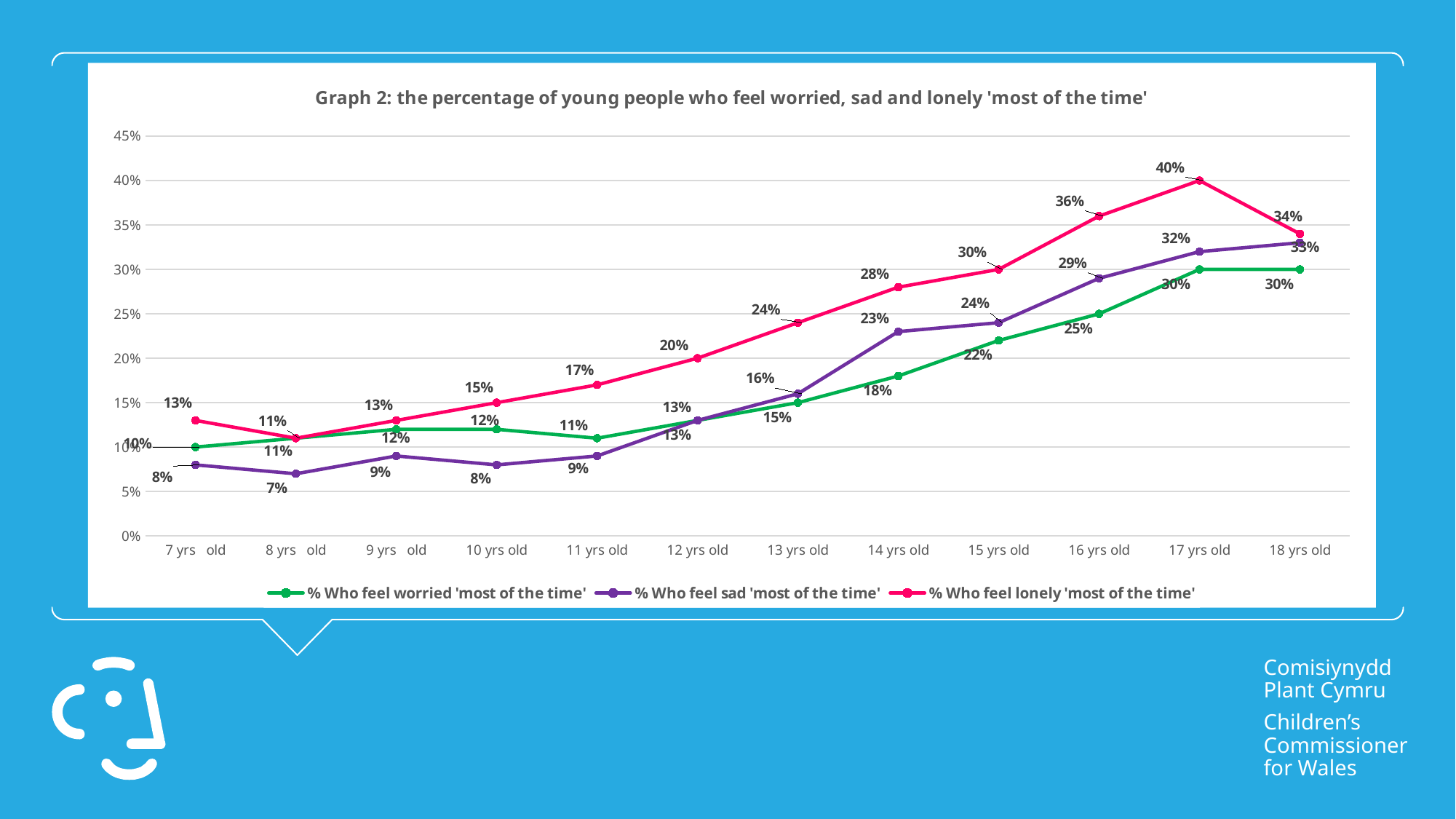
Which colour is used for the '% Who feel lonely 'most of the time'' line? pink Does the percentage who feel sad 'most of the time' generally rise or fall from 7 yrs old to 18 yrs old? rise What is the difference between the percentage of 18 year olds who feel lonely and the percentage who feel worried 'most of the time'? 4% How many series does the legend list? 3 What percentage of 15 year olds feel worried 'most of the time'? 22% What type of chart is shown on the slide? line chart At 14 yrs old, which is larger: the percentage who feel sad or the percentage who feel worried 'most of the time'? % Who feel sad 'most of the time' What percentage of 8 year olds feel sad 'most of the time'? 7% At which age is the percentage who feel lonely 'most of the time' highest? 17 yrs old At which age is the percentage who feel sad 'most of the time' lowest? 8 yrs old What percentage of 17 year olds feel lonely 'most of the time'? 40% How many age categories are shown on the x axis? 12